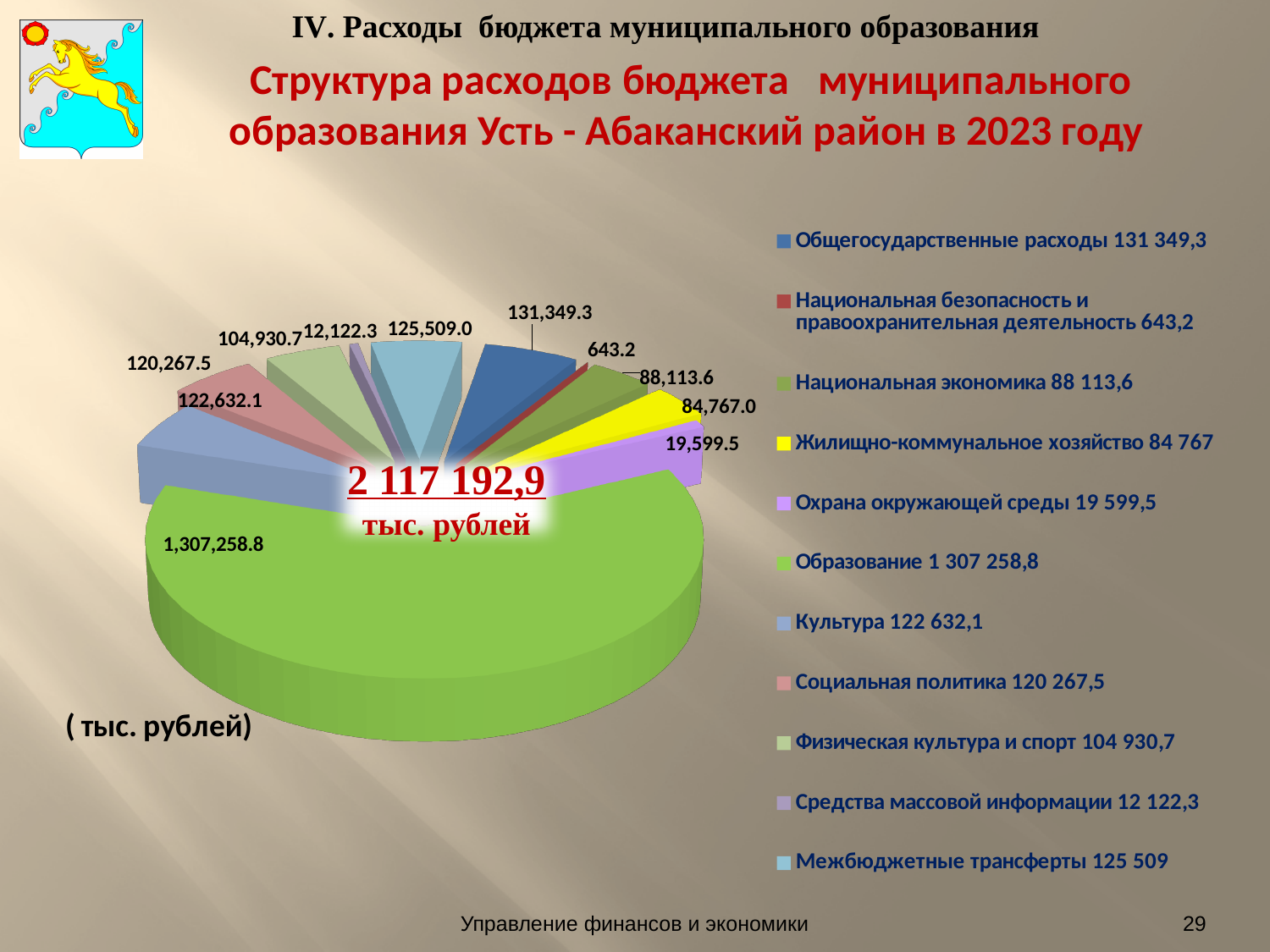
What is the value for Образование (education) in the pie chart? 1,307,258.8 What is the value for Национальная безопасность и правоохранительная деятельность? 643.2 What unit is shown below the pie chart? тыс. рублей What is the value for Межбюджетные трансферты? 125,509.0 What total amount is printed in the centre of the pie chart? 2 117 192,9 тыс. рублей What is the difference between Общегосударственные расходы (131,349.3) and Межбюджетные трансферты (125,509.0)? 5,840.3 What is the value for Общегосударственные расходы in the pie chart? 131,349.3 What kind of chart is shown on the slide? pie chart Which category has the smallest slice of the pie? Национальная безопасность и правоохранительная деятельность Which category has the largest slice of the pie? Образование How many slices does the pie chart have? 11 Which is larger: Культура or Социальная политика? Культура